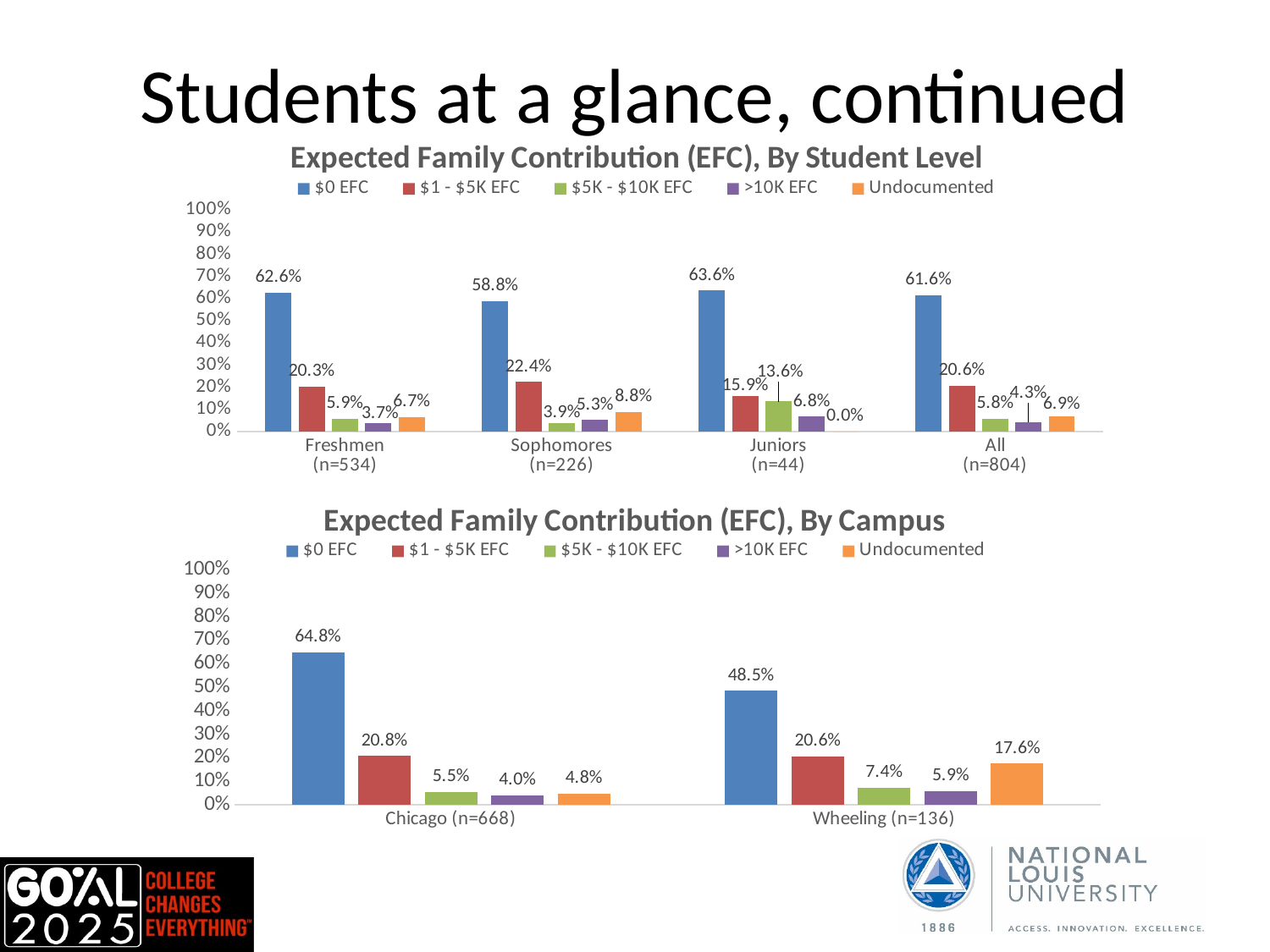
In the 'Expected Family Contribution (EFC), By Student Level' chart, what is the Undocumented value for Sophomores (n=226)? 8.8% In the 'Expected Family Contribution (EFC), By Campus' chart, what is the Undocumented value for Wheeling (n=136)? 17.6% In the 'Expected Family Contribution (EFC), By Campus' chart, which campus has the larger $5K - $10K EFC value? Wheeling (n=136) What kind of chart is the 'Expected Family Contribution (EFC), By Campus' chart? Bar chart In the 'Expected Family Contribution (EFC), By Student Level' chart, which student level has the highest $1 - $5K EFC value? Sophomores (n=226) In the 'Expected Family Contribution (EFC), By Student Level' chart, what is the difference between the $0 EFC values for Juniors (n=44) and Sophomores (n=226)? 4.8% In the 'Expected Family Contribution (EFC), By Student Level' chart, what is the $0 EFC value for Juniors (n=44)? 63.6% In the 'Expected Family Contribution (EFC), By Student Level' chart, how many student level categories are shown on the x axis? 4 In the 'Expected Family Contribution (EFC), By Campus' chart, which colour represents the Undocumented series? Orange In the 'Expected Family Contribution (EFC), By Student Level' chart, how many series does the legend list? 5 In the 'Expected Family Contribution (EFC), By Student Level' chart, which student level has the lowest Undocumented value? Juniors (n=44) In the 'Expected Family Contribution (EFC), By Campus' chart, what is the difference between the $0 EFC values for Chicago (n=668) and Wheeling (n=136)? 16.3%